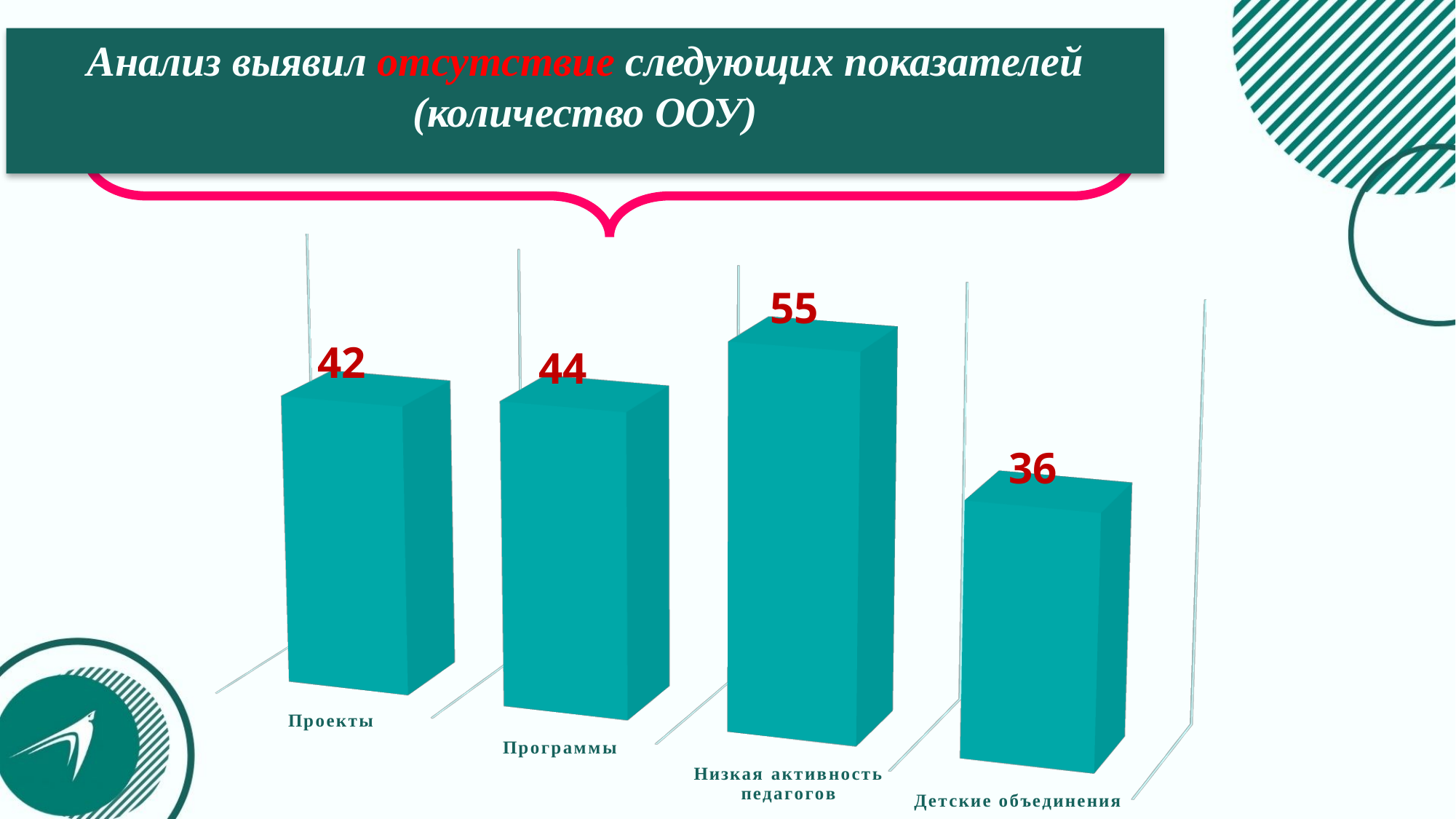
What kind of chart is shown on the slide? Bar chart Which category has the highest value? Низкая активность педагогов What is the difference between the values for Низкая активность педагогов and Детские объединения? 19 What is the value for Низкая активность педагогов? 55 What is the value for Программы? 44 How many categories are shown in the chart? 4 Which category has the lowest value? Детские объединения What is the difference between the values for Программы and Проекты? 2 What is the value for Проекты? 42 What is the title of the slide above the chart? Анализ выявил отсутствие следующих показателей (количество ООУ) Which is larger, the value for Проекты or the value for Детские объединения? Проекты What is the value for Детские объединения? 36